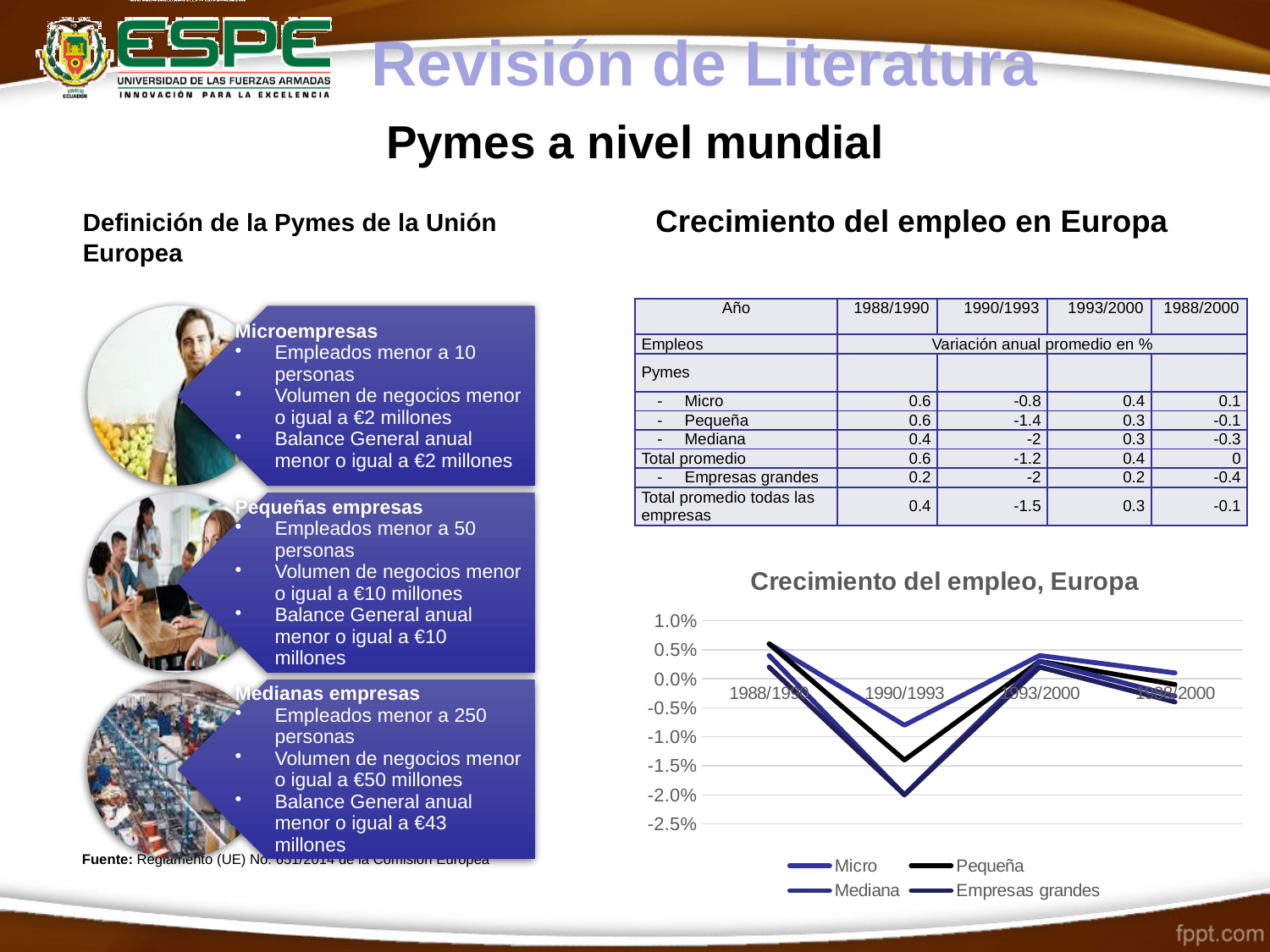
How many periods are shown on the x axis of the 'Crecimiento del empleo, Europa' chart? 4 In the 'Crecimiento del empleo, Europa' chart, is the value for Micro in 1988/1990 greater or less than 0.0%? greater What is the title of the line chart on the slide? Crecimiento del empleo, Europa What kind of chart is 'Crecimiento del empleo, Europa'? line chart In the 'Crecimiento del empleo, Europa' chart, is the value for Micro in 1990/1993 greater or less than -0.5%? less How many series does the legend of the 'Crecimiento del empleo, Europa' chart list? 4 In the 'Crecimiento del empleo, Europa' chart, is the value for Pequeña in 1990/1993 greater or less than -1.0%? less In the 'Crecimiento del empleo, Europa' chart, which is higher in 1990/1993: Micro or Pequeña? Micro In the 'Crecimiento del empleo, Europa' chart, which series has the highest value in 1990/1993? Micro In the 'Crecimiento del empleo, Europa' chart, do the series rise or fall from 1988/1990 to 1990/1993? fall